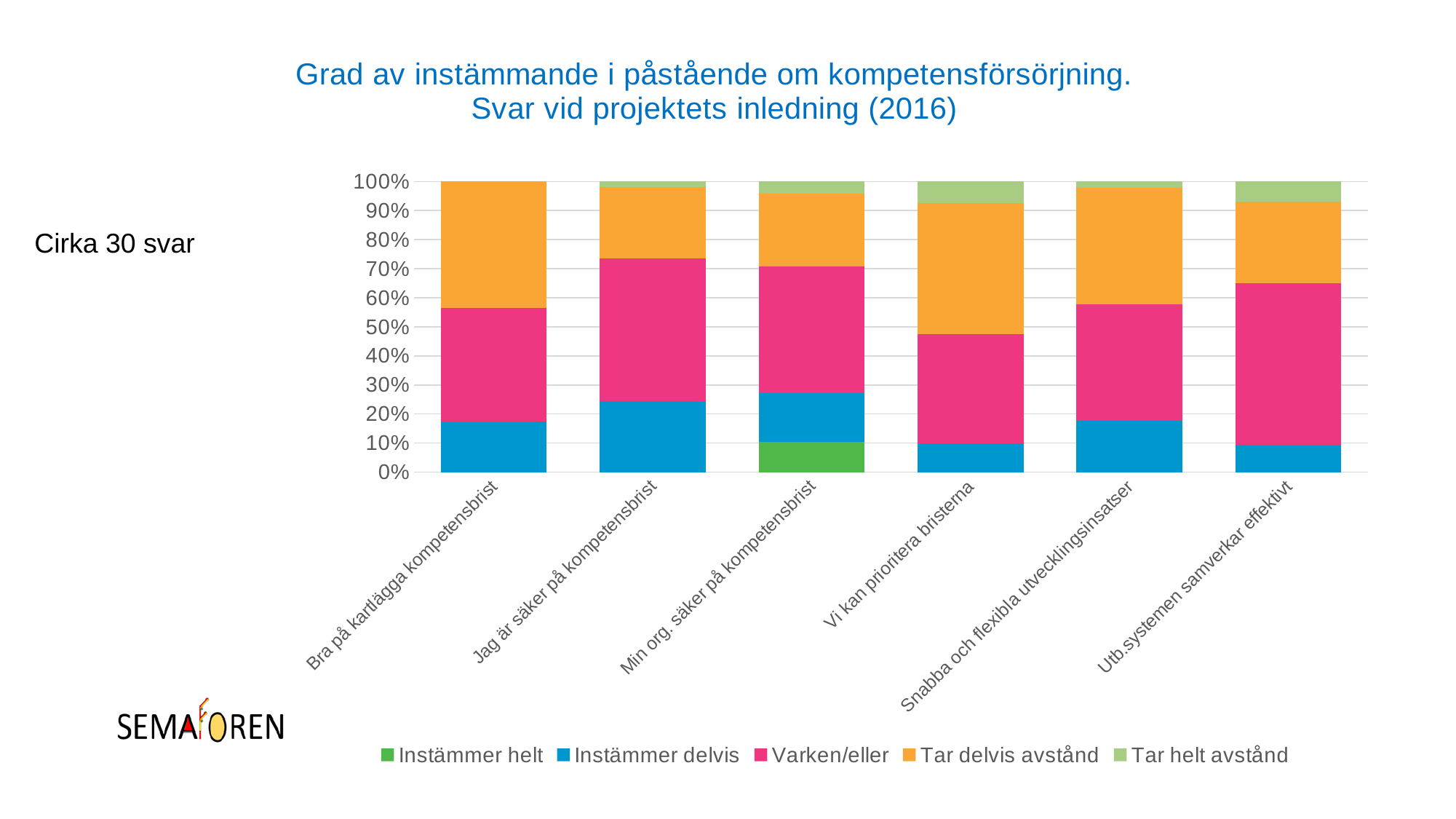
Is the 'Varken/eller' share for 'Utb.systemen samverkar effektivt' greater or less than 50%? greater Is the 'Instämmer delvis' share for 'Jag är säker på kompetensbrist' greater or less than 20%? greater Which statement has the largest 'Instämmer delvis' share? Jag är säker på kompetensbrist Which statement has the largest 'Varken/eller' share? Utb.systemen samverkar effektivt Which has the larger 'Instämmer delvis' share: 'Jag är säker på kompetensbrist' or 'Vi kan prioritera bristerna'? Jag är säker på kompetensbrist How many statements (categories) are shown along the x axis? 6 Which series is shown in orange in the legend? Tar delvis avstånd Which has the larger 'Varken/eller' share: 'Utb.systemen samverkar effektivt' or 'Vi kan prioritera bristerna'? Utb.systemen samverkar effektivt Is the 'Instämmer delvis' share for 'Bra på kartlägga kompetensbrist' greater or less than 20%? less What kind of chart is shown on the slide? Stacked bar chart Which statement is the only one with an 'Instämmer helt' segment? Min org. säker på kompetensbrist How many series does the legend list? 5